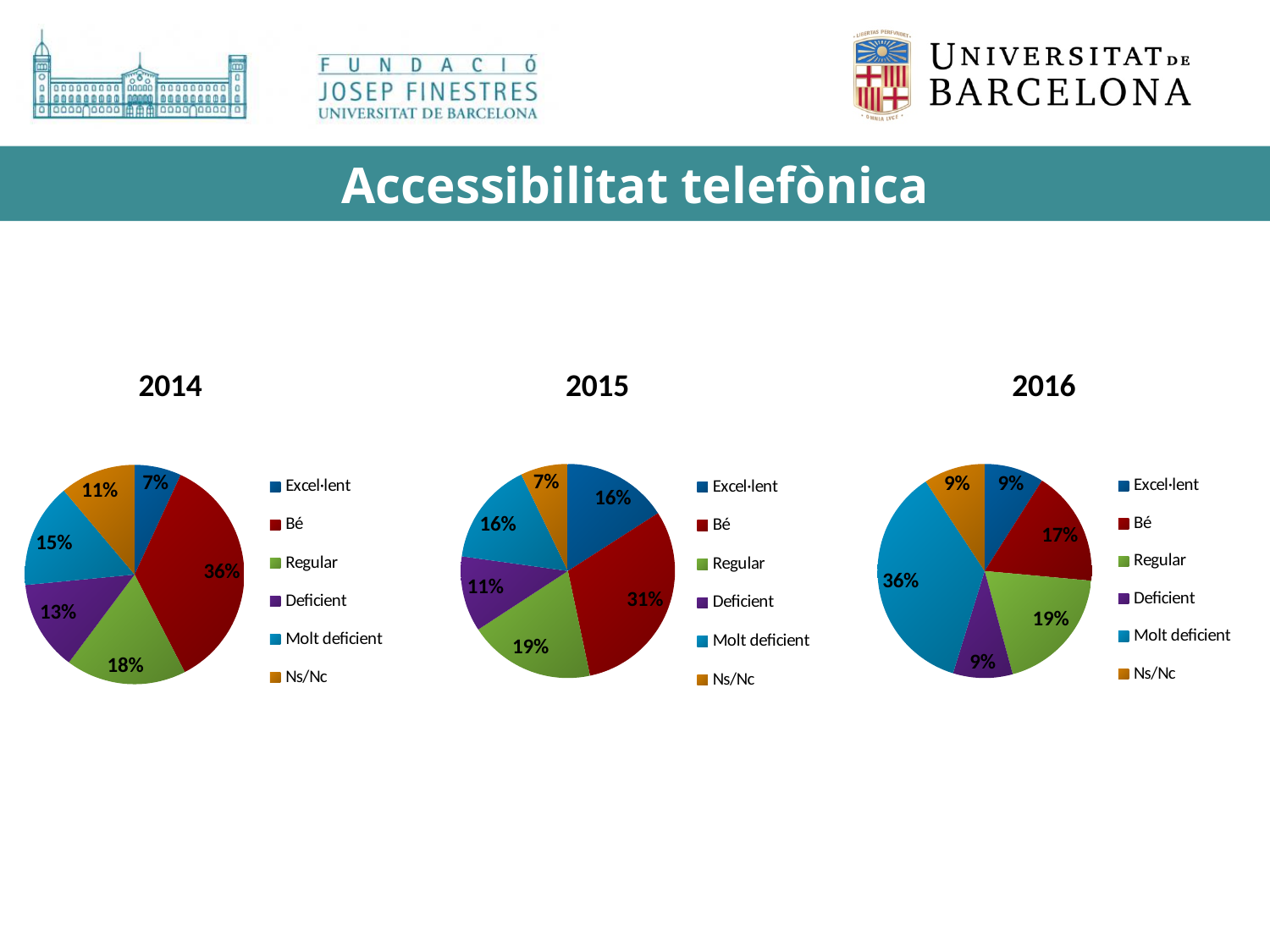
In the 2014 pie chart, which category has the largest share? Bé In the 2015 pie chart, what share does Excel·lent have? 16% In the 2016 pie chart, which category has the largest share? Molt deficient In the 2015 pie chart, which is larger, the share of Regular or the share of Deficient? Regular In the 2014 pie chart, what is the difference between the shares of Bé and Regular? 18% What is the title of the slide containing the three pie charts? Accessibilitat telefònica In the 2015 pie chart, which category has the smallest share? Ns/Nc In the 2016 pie chart, what share does Molt deficient have? 36% In the 2016 pie chart, what share does Regular have? 19% How many categories does the legend of the 2016 pie chart list? 6 In the 2014 pie chart, what share does Bé have? 36% What type of chart is used for the 2015 data? Pie chart